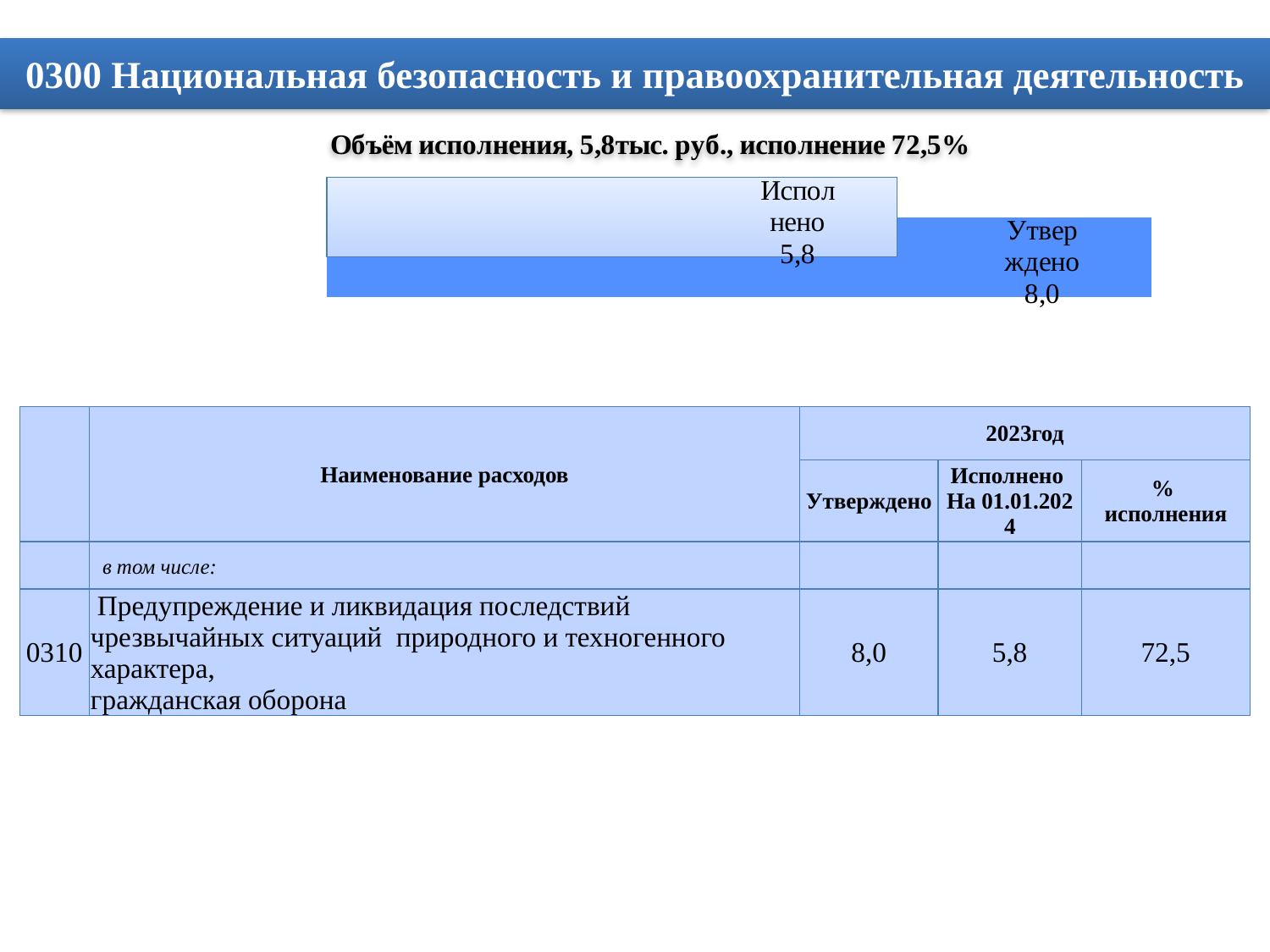
How many bars are plotted in the chart? 2 What is the value of the bar labelled Утверждено? 8,0 Which bar has the highest value? Утверждено What is the difference between the Утверждено and Исполнено values? 2,2 What kind of chart is shown on the slide? bar chart Which bar has the lowest value? Исполнено What is the value of the bar labelled Исполнено? 5,8 What is the title shown above the chart? Объём исполнения, 5,8тыс. руб., исполнение 72,5% Which is larger, the Исполнено value or the Утверждено value? Утверждено Which bar is positioned above the other in the chart? Исполнено